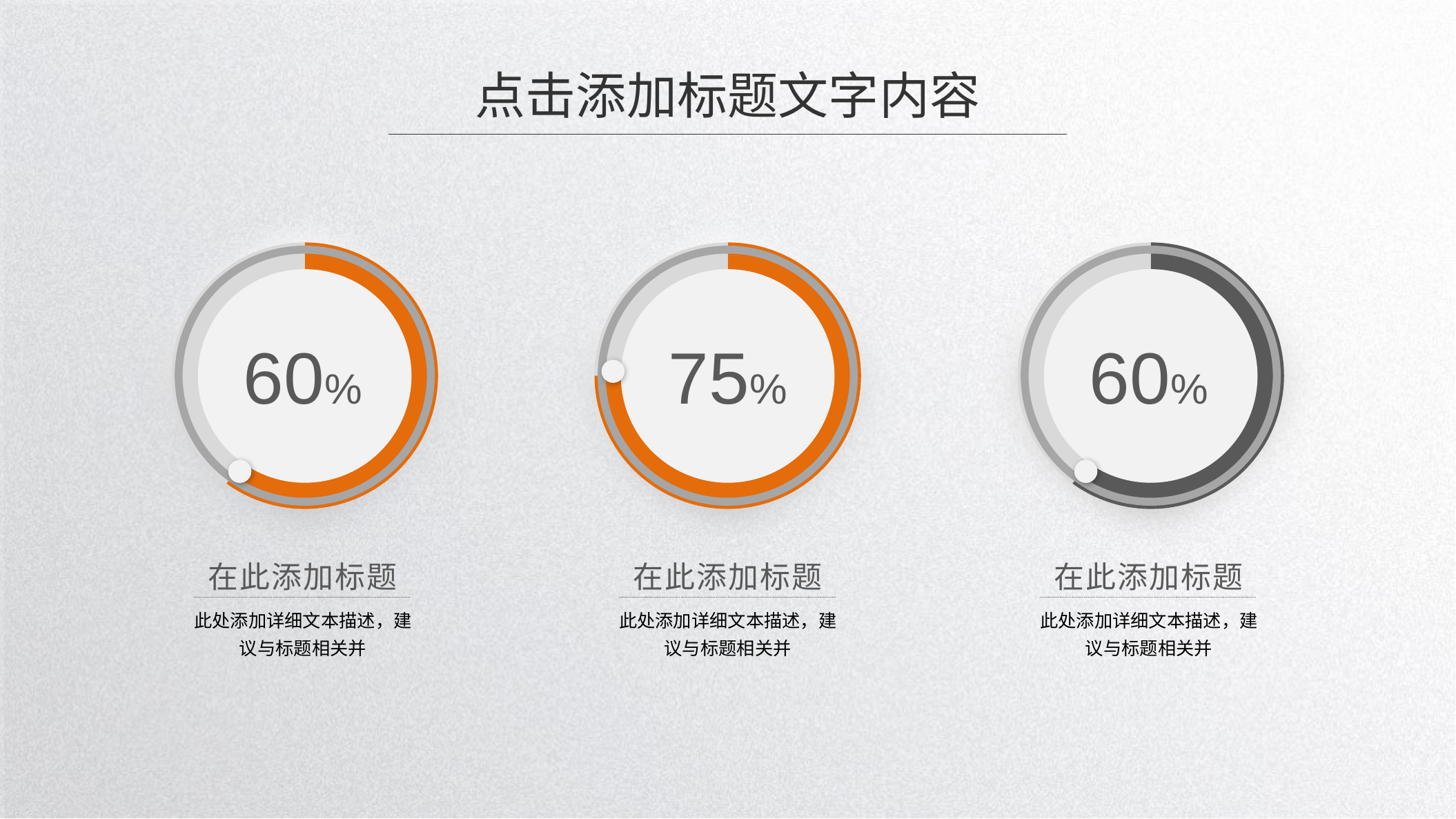
What is the difference between the middle chart's value and the right chart's value? 15% What value is shown in the right circular chart? 60% Do the left and right charts show the same value? Yes, both show 60% What colour is the filled arc of the left and middle charts? Orange What value is shown in the left circular chart? 60% What colour is the filled arc of the right chart? Dark grey Is the value in the middle chart larger or smaller than the value in the left chart? Larger What kind of chart is used to display the percentages on the slide? Circular progress (ring/donut) charts Which of the three circular charts shows the highest value? The middle chart (75%) What value is shown in the middle circular chart? 75% How many circular progress charts are on the slide? 3